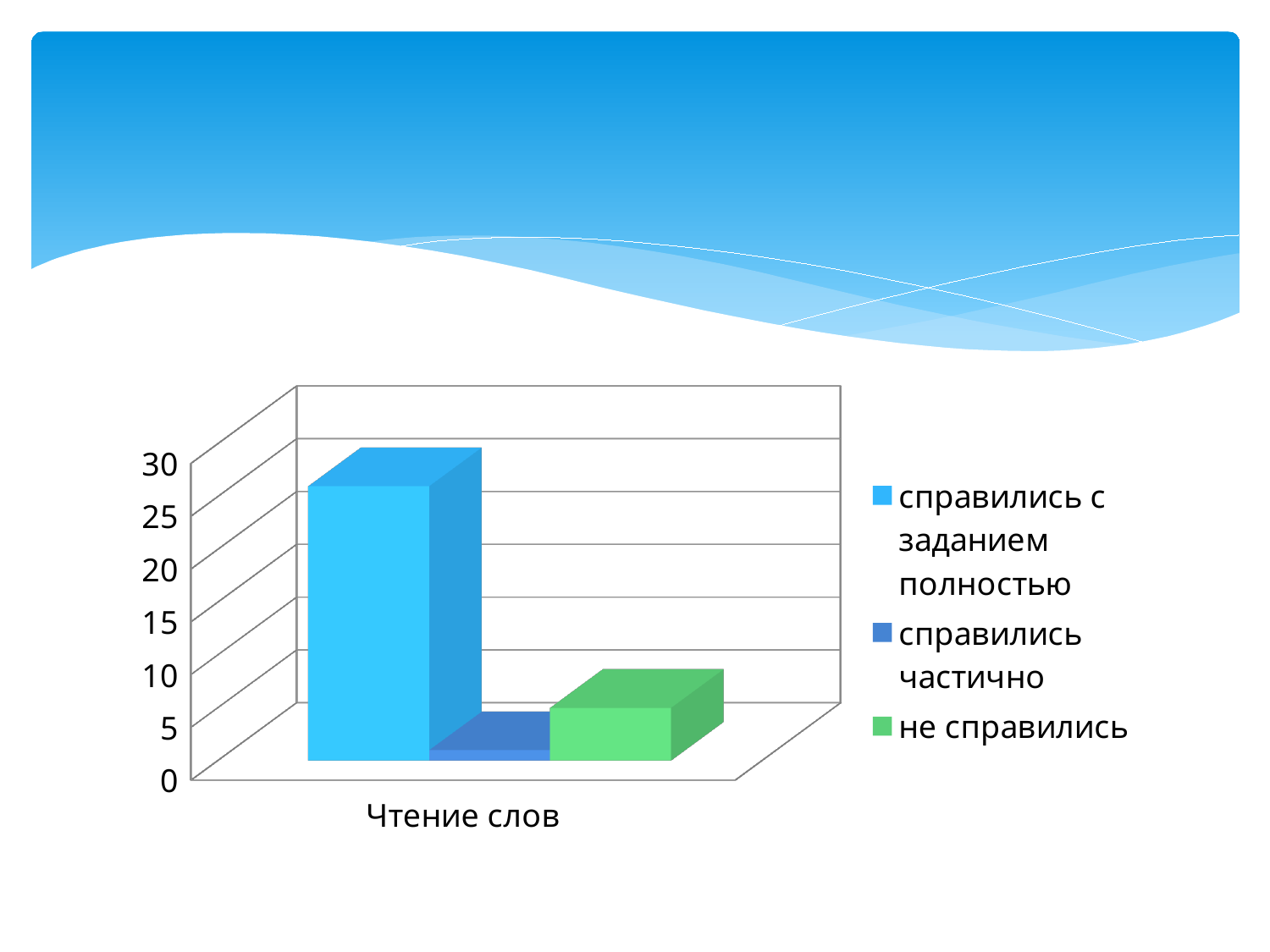
Is the value for справились частично greater or less than 5? less Is the value for не справились greater or less than 10? less What is the category label on the x axis? Чтение слов Which series has the lowest value for Чтение слов? справились частично Which is larger for Чтение слов: не справились or справились частично? не справились Which series has the highest value for Чтение слов? справились с заданием полностью Is the value for справились с заданием полностью greater or less than 20? greater What kind of chart is shown on the slide? bar chart How many categories are shown on the x axis? 1 How many series does the legend list? 3 Which is larger for Чтение слов: справились с заданием полностью or не справились? справились с заданием полностью What colour is the bar for не справились? green